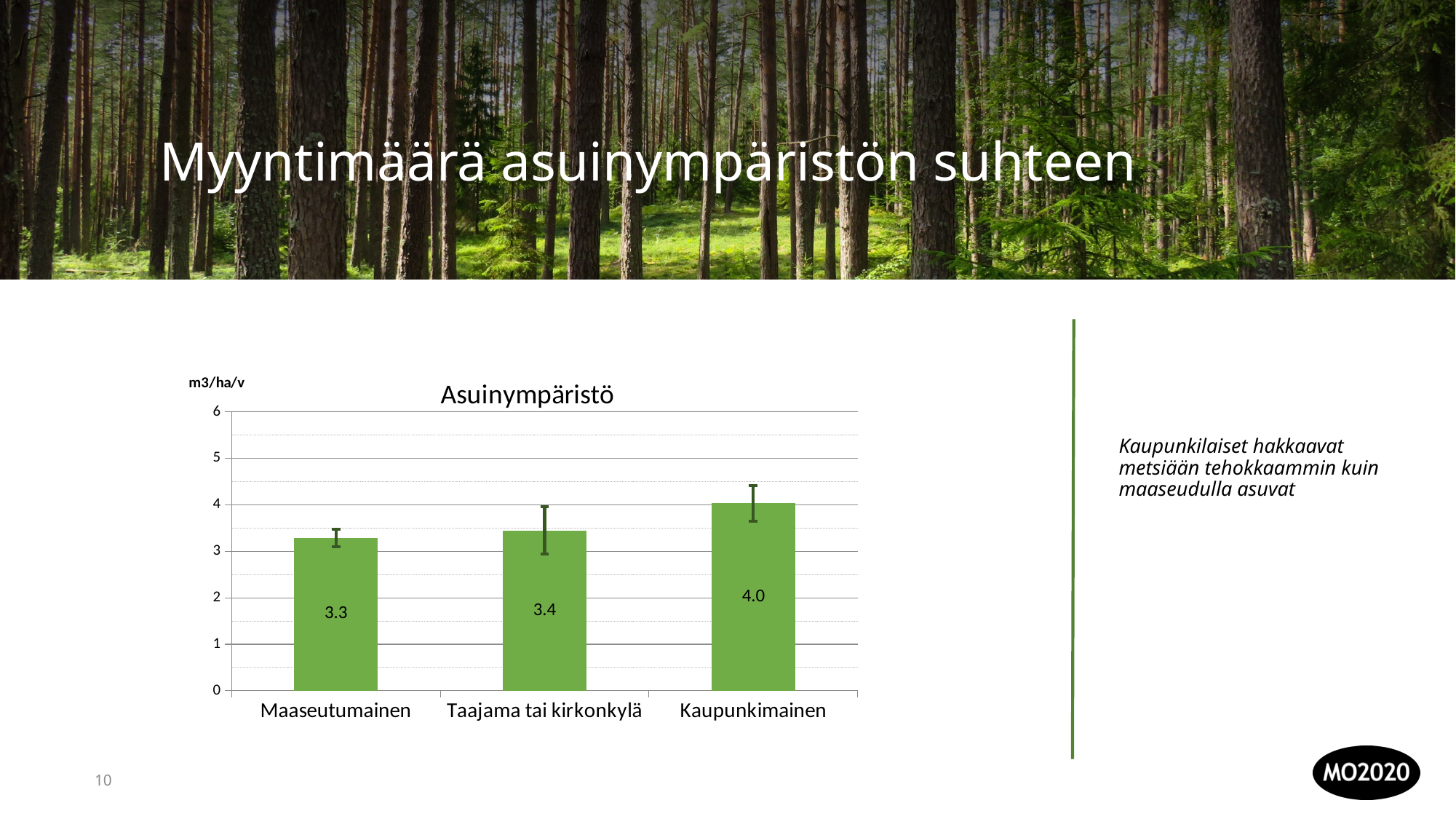
What is the difference between the values for Kaupunkimainen and Taajama tai kirkonkylä? 0.6 Which is larger, the value for Kaupunkimainen or the value for Maaseutumainen? Kaupunkimainen Which category has the highest value? Kaupunkimainen What kind of chart is shown on the slide? bar chart What is the value for Kaupunkimainen? 4.0 What is the title of the chart? Asuinympäristö How many categories are shown on the x axis? 3 What is the difference between the values for Kaupunkimainen and Maaseutumainen? 0.7 What is the value for Maaseutumainen? 3.3 Which category has the lowest value? Maaseutumainen Is the value for Maaseutumainen greater or less than 4? less What is the value for Taajama tai kirkonkylä? 3.4